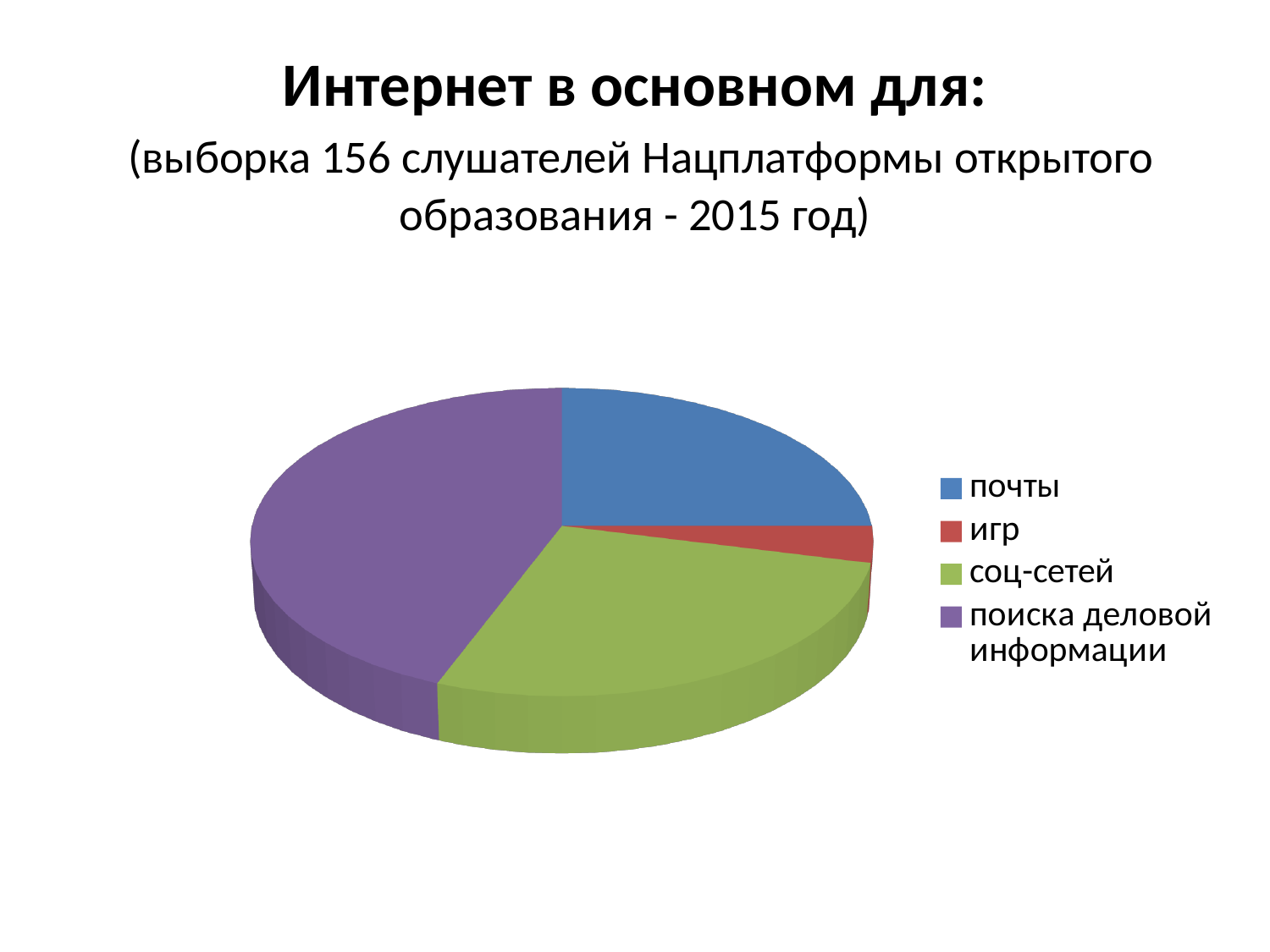
What colour is the slice for игр? red Which category has the largest slice of the pie? поиска деловой информации What is the title of the slide above the chart? Интернет в основном для: How many categories (slices) does the pie chart have? 4 What kind of chart is shown on the slide? pie chart Which slice is larger: соц-сетей or почты? соц-сетей Which slice is larger: поиска деловой информации or почты? поиска деловой информации Which category has the smallest slice of the pie? игр Which slice is larger: почты or игр? почты How many entries does the legend list? 4